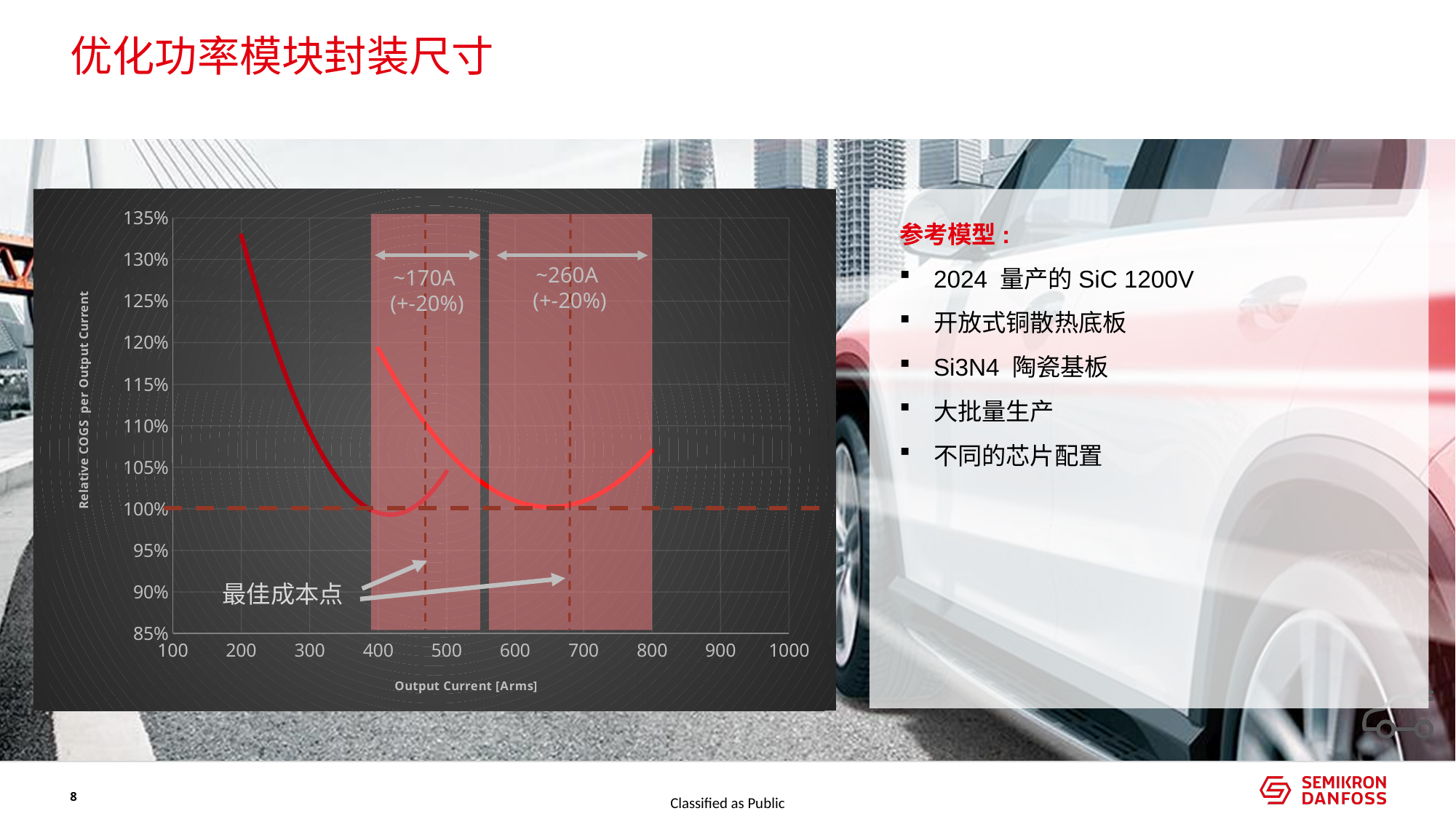
What is the label of the y axis of the chart? Relative COGS per Output Current Does the right curve rise or fall as output current increases from 700 to 800? rise At what level is the horizontal dashed reference line drawn on the chart? 100% What is the highest tick value shown on the x axis? 1000 What current value is labelled on the left shaded region of the chart? ~170A (+-20%) How many red curves are plotted on the chart? 2 What kind of chart is shown on the slide? line chart Does the left curve rise or fall as output current increases from 200 to 400? fall Is the value of the right curve at an output current of 800 greater or less than 100%? greater What is the label of the x axis of the chart? Output Current [Arms] Is the value of the left curve at an output current of 200 greater or less than 130%? greater What is the lowest tick value shown on the y axis? 85%